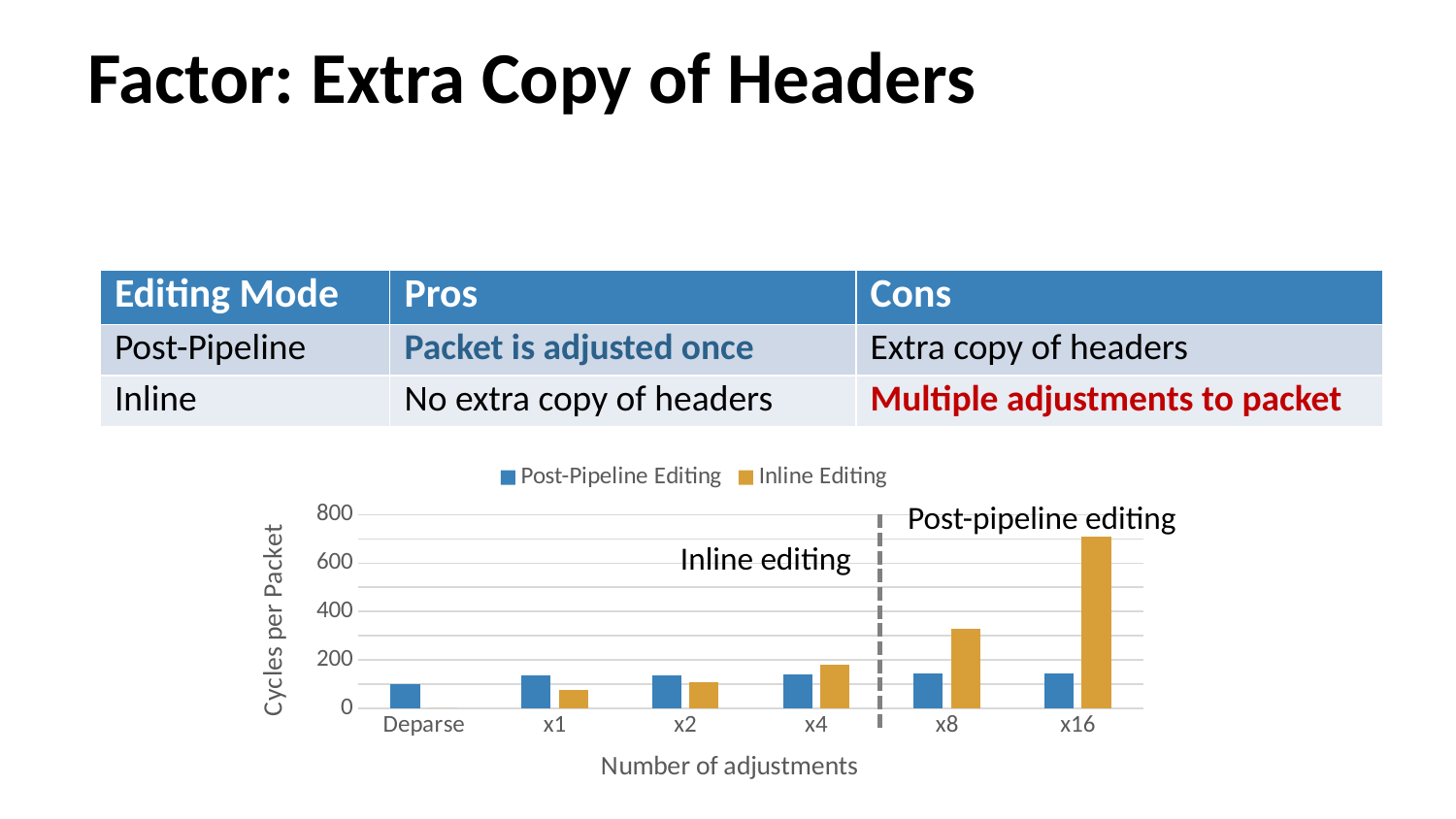
At x1, which series has the larger value, Post-Pipeline Editing or Inline Editing? Post-Pipeline Editing What is the label of the chart's y axis? Cycles per Packet What kind of chart is shown on the slide? bar chart At which category does Inline Editing reach its highest value? x16 How many series does the chart legend list? 2 Is the Inline Editing value at x8 greater or less than 200? greater Do the Inline Editing values rise or fall as the number of adjustments increases from x1 to x16? rise Is the Inline Editing value at x16 greater or less than 600? greater Is the Post-Pipeline Editing value at Deparse greater or less than 200? less How many categories are shown on the x axis of the chart? 6 At x16, which series has the larger value, Post-Pipeline Editing or Inline Editing? Inline Editing